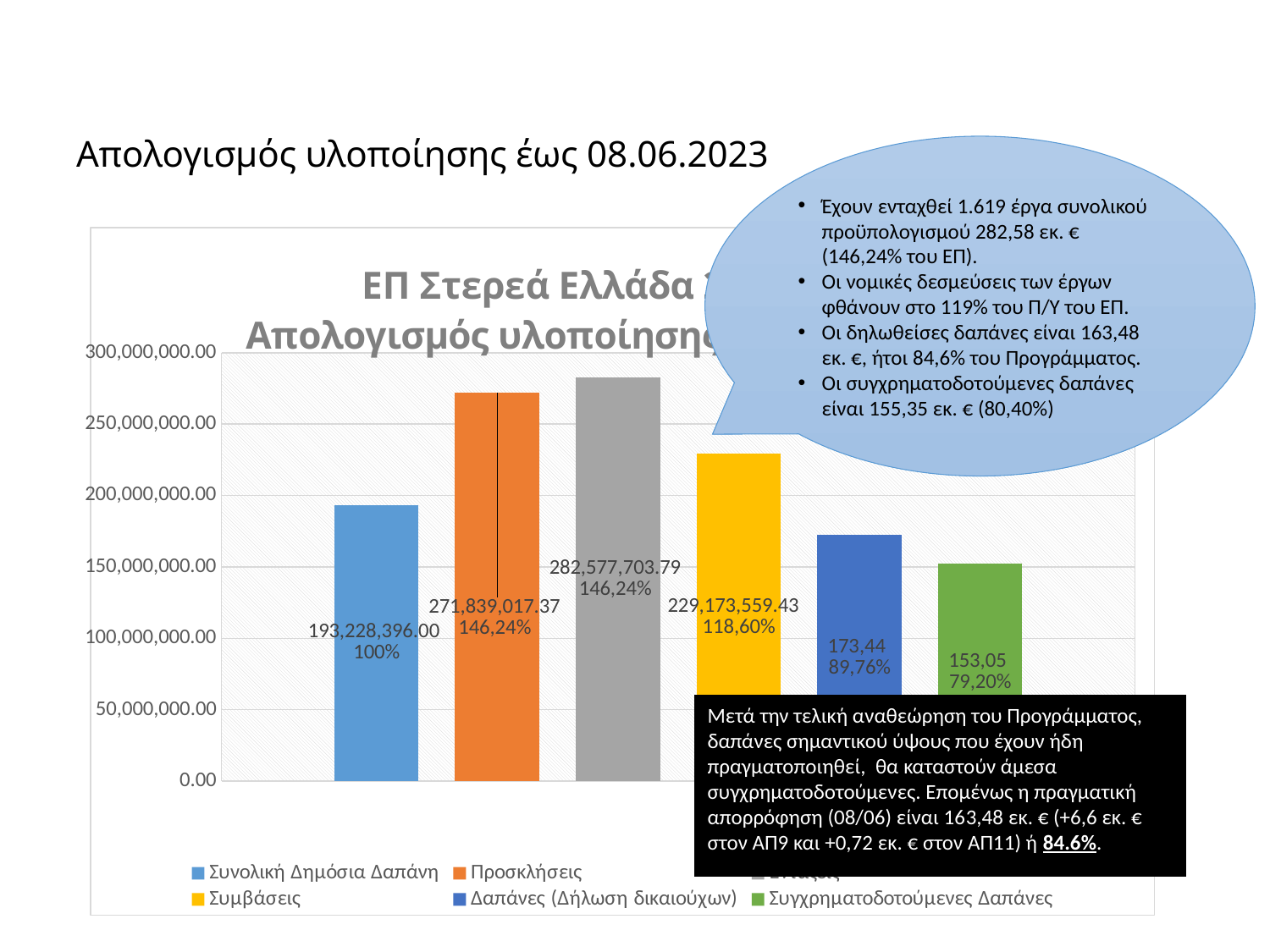
Which series has the lowest bar in the chart? Συγχρηματοδοτούμενες Δαπάνες What percentage is shown on the Δαπάνες (Δήλωση δικαιούχων) bar? 89,76% What is the value of the highest bar in the chart? 282,577,703.79 What kind of chart is shown on the slide? bar chart Which is larger, Συμβάσεις or Συνολική Δημόσια Δαπάνη? Συμβάσεις How many bars are plotted in the chart? 6 What is the difference between the Προσκλήσεις value and the Συνολική Δημόσια Δαπάνη value? 78,610,621.37 Is the value for Δαπάνες (Δήλωση δικαιούχων) greater or less than 200,000,000.00? less What is the value shown for Συμβάσεις? 229,173,559.43 What percentage is shown on the Συμβάσεις bar? 118,60% What is the value shown for Προσκλήσεις? 271,839,017.37 What is the value shown for Συνολική Δημόσια Δαπάνη? 193,228,396.00